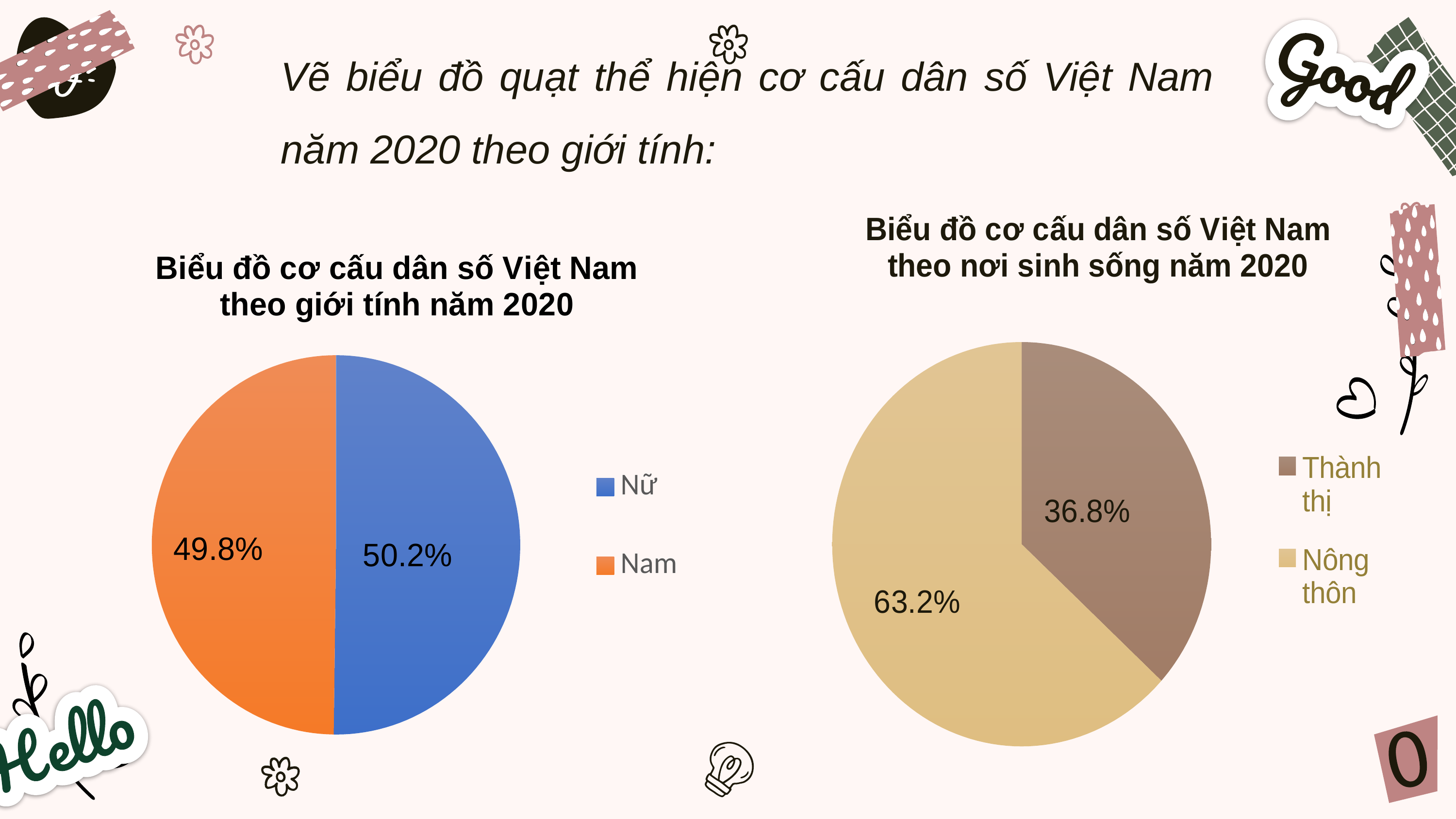
In the left chart (theo giới tính năm 2020), what is the difference between the Nữ and Nam shares? 0.4% In the right chart (Biểu đồ cơ cấu dân số Việt Nam theo nơi sinh sống năm 2020), what is the value for Thành thị? 36.8% What kind of chart is the left chart (theo giới tính năm 2020)? Pie chart In the left chart (theo giới tính năm 2020), what colour is the Nam slice? Orange In the right chart (theo nơi sinh sống năm 2020), which category has the largest share? Nông thôn How many categories does the right chart (theo nơi sinh sống năm 2020) show? 2 In the left chart (Biểu đồ cơ cấu dân số Việt Nam theo giới tính năm 2020), what is the value for Nam? 49.8% In the right chart (theo nơi sinh sống năm 2020), what is the difference between the Nông thôn and Thành thị shares? 26.4% In the left chart (Biểu đồ cơ cấu dân số Việt Nam theo giới tính năm 2020), what is the value for Nữ? 50.2% In the left chart (theo giới tính năm 2020), which is larger according to the printed labels, Nữ or Nam? Nữ In the right chart (theo nơi sinh sống năm 2020), which category has the smallest share? Thành thị In the right chart (Biểu đồ cơ cấu dân số Việt Nam theo nơi sinh sống năm 2020), what is the value for Nông thôn? 63.2%